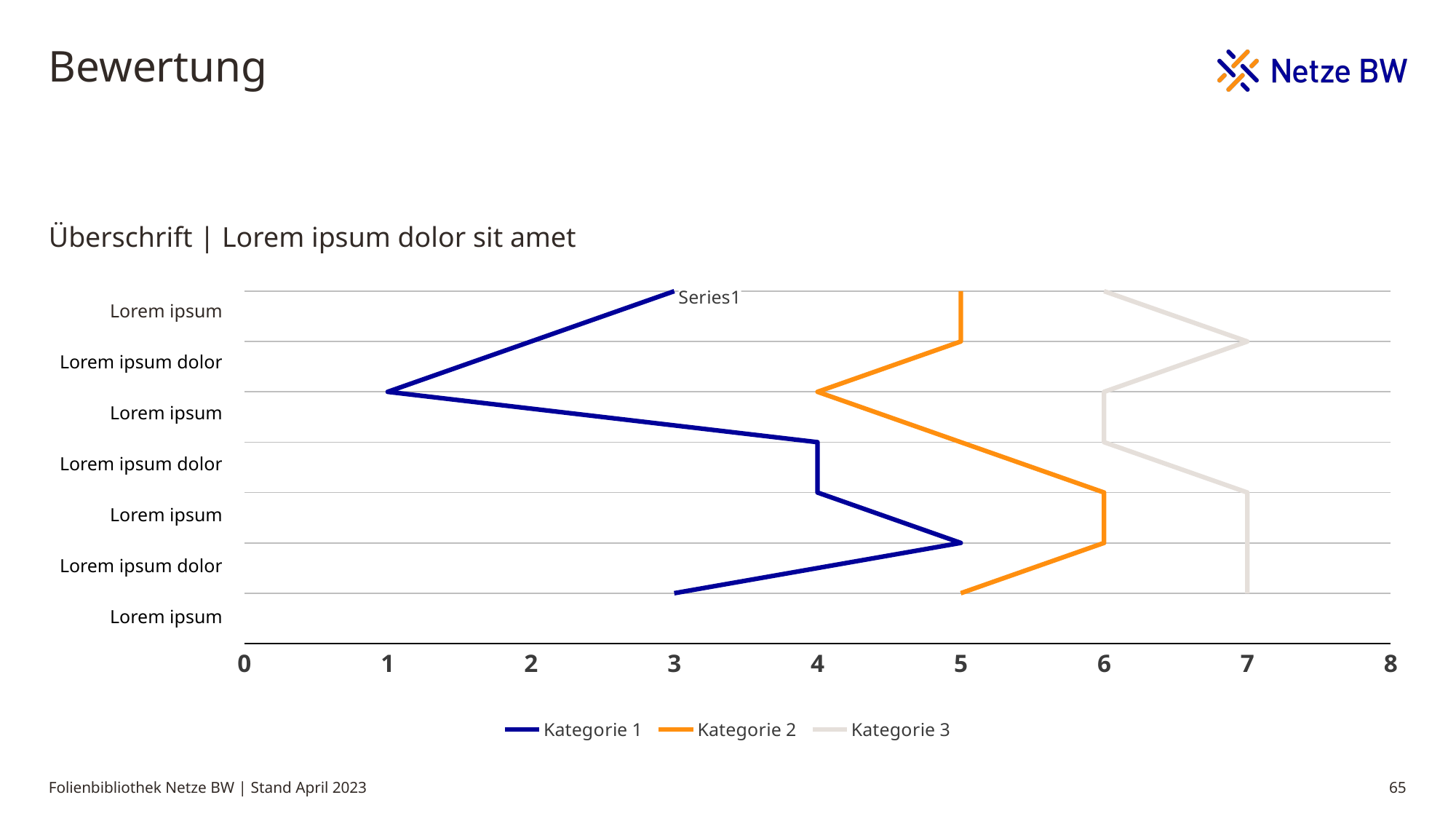
At the topmost category, which series has the highest value? Kategorie 3 What is the lowest value reached by the Kategorie 2 line? 4 At the topmost category, is the value of Kategorie 1 greater or less than 4? less Which series is drawn in orange? Kategorie 2 What kind of chart is shown on the slide? line chart How many series does the chart legend list? 3 What is the highest value reached by the Kategorie 3 line? 7 What is the highest value reached by the Kategorie 2 line? 6 How many category labels are shown on the vertical axis of the chart? 7 What is the maximum value shown on the horizontal axis of the chart? 8 What is the lowest value reached by the Kategorie 1 line? 1 What are the series names listed in the chart legend? Kategorie 1, Kategorie 2, Kategorie 3